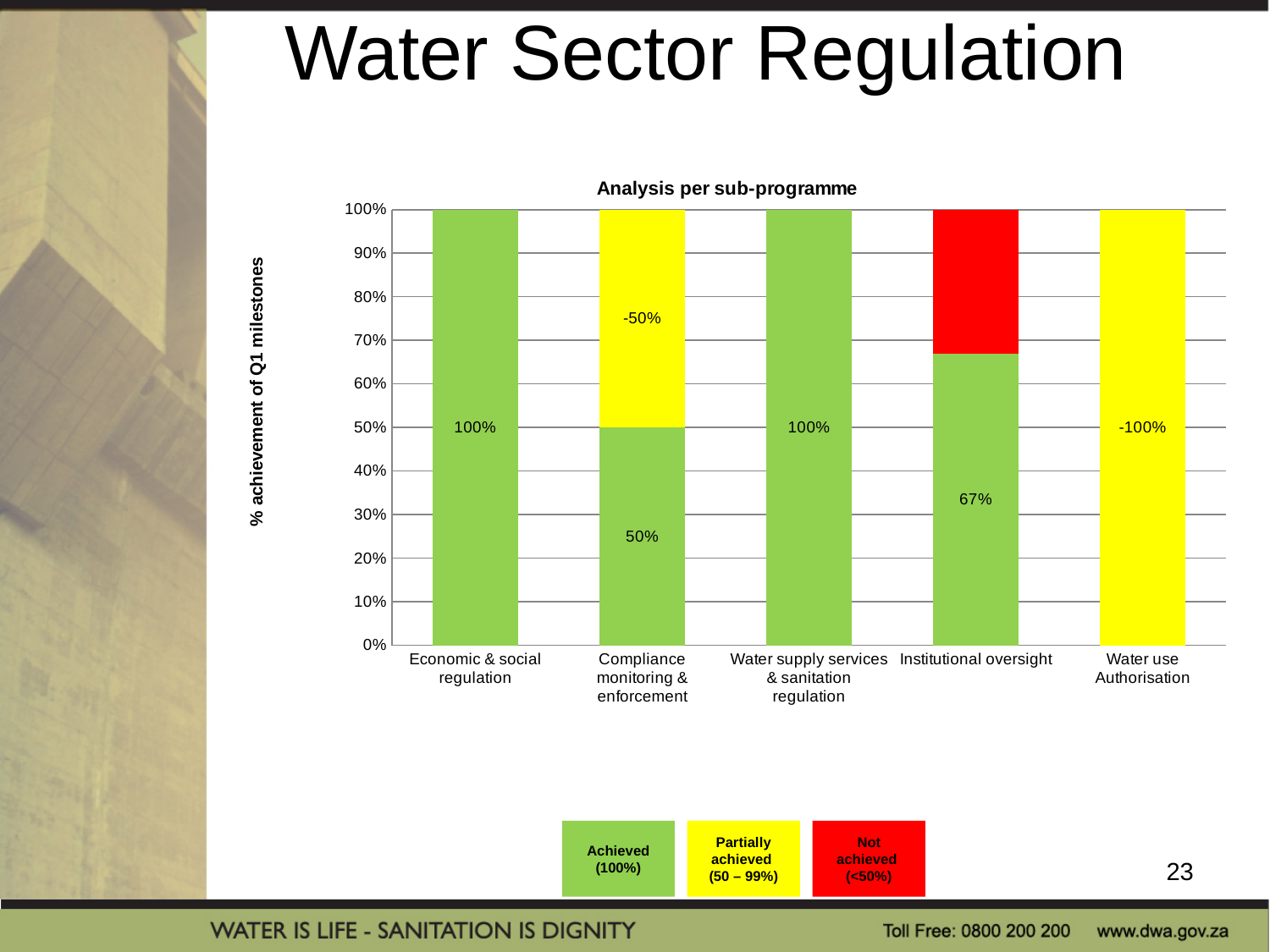
What kind of chart is shown on the slide? Stacked bar chart What value is printed on the green segment for Institutional oversight? 67% What value is printed on the green segment for Economic & social regulation? 100% Is the red (Not achieved) segment for Institutional oversight greater or less than 40%? less What is the difference between the green segment values for Economic & social regulation and Institutional oversight? 33% What value is printed on the green segment for Compliance monitoring & enforcement? 50% Which has the larger green (Achieved) segment: Institutional oversight or Compliance monitoring & enforcement? Institutional oversight How many categories does the legend below the chart list? 3 What value is printed on the yellow segment for Compliance monitoring & enforcement? -50% What value is printed on the yellow segment for Water use Authorisation? -100% What is the title of the chart? Analysis per sub-programme How many sub-programme categories are shown on the x axis of the chart? 5